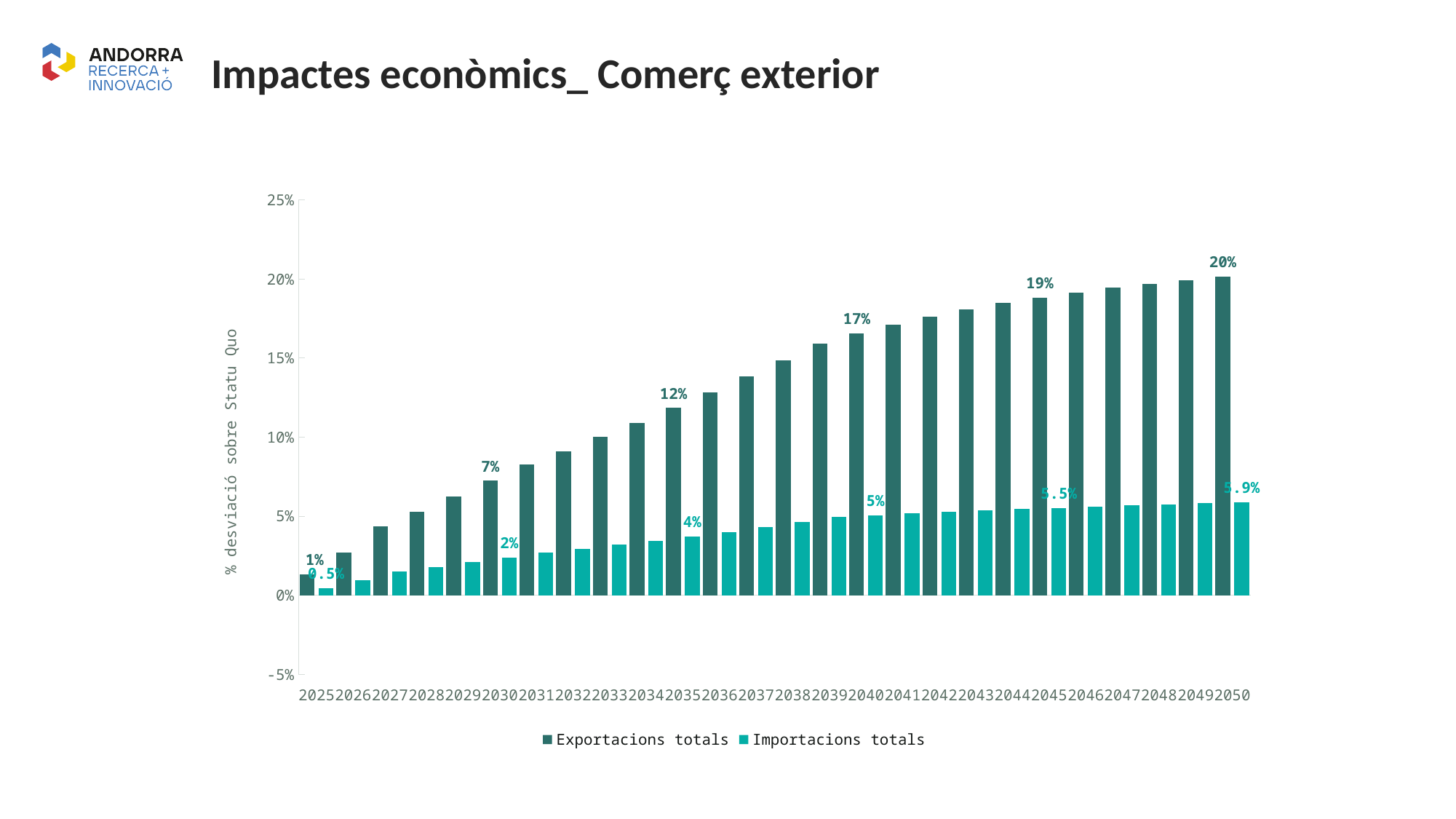
How many series does the legend list? 2 Which year has the lowest value for Importacions totals? 2025 What is the label of the vertical axis? % desviació sobre Statu Quo What is the value of Importacions totals in 2025? 0.5% What is the value of Exportacions totals in 2050? 20% What is the value of Exportacions totals in 2035? 12% Do the values for Exportacions totals rise or fall from 2025 to 2050? rise What type of chart is shown on the slide? bar chart What is the value of Importacions totals in 2045? 5.5% Which year has the highest value for Exportacions totals? 2050 What is the difference between Exportacions totals and Importacions totals in 2040? 12%